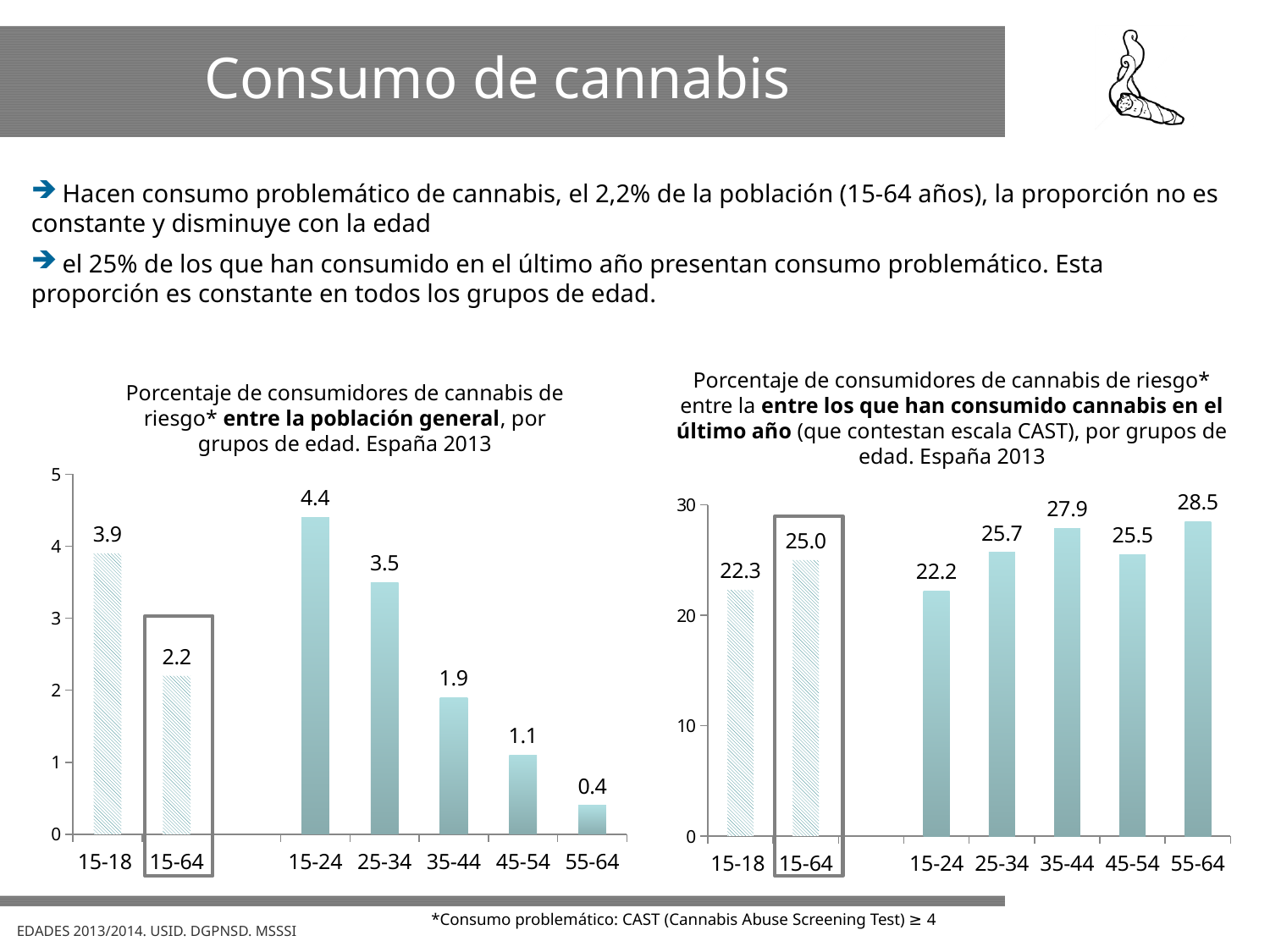
In the right chart (consumido cannabis en el último año), which age group has the highest value? 55-64 In the left chart (población general), which age group has the highest value? 15-24 In the left chart (población general), how many bars are plotted? 7 In the right chart (consumido cannabis en el último año), which age group has the lowest value? 15-24 In the right chart (consumido cannabis en el último año), which is larger, the value for 25-34 or for 45-54? 25-34 In the left chart (población general), what is the difference between the 15-24 and 25-34 values? 0.9 In the left chart (población general), what is the value for the 15-24 age group? 4.4 What type of chart is the left chart (población general)? bar chart In the left chart (población general), do the values rise or fall from 15-24 to 55-64? fall In the left chart (población general), what is the value for the 55-64 age group? 0.4 In the right chart (consumido cannabis en el último año), what is the value for the 35-44 age group? 27.9 In the right chart (consumido cannabis en el último año), what is the difference between the 55-64 and 15-64 values? 3.5